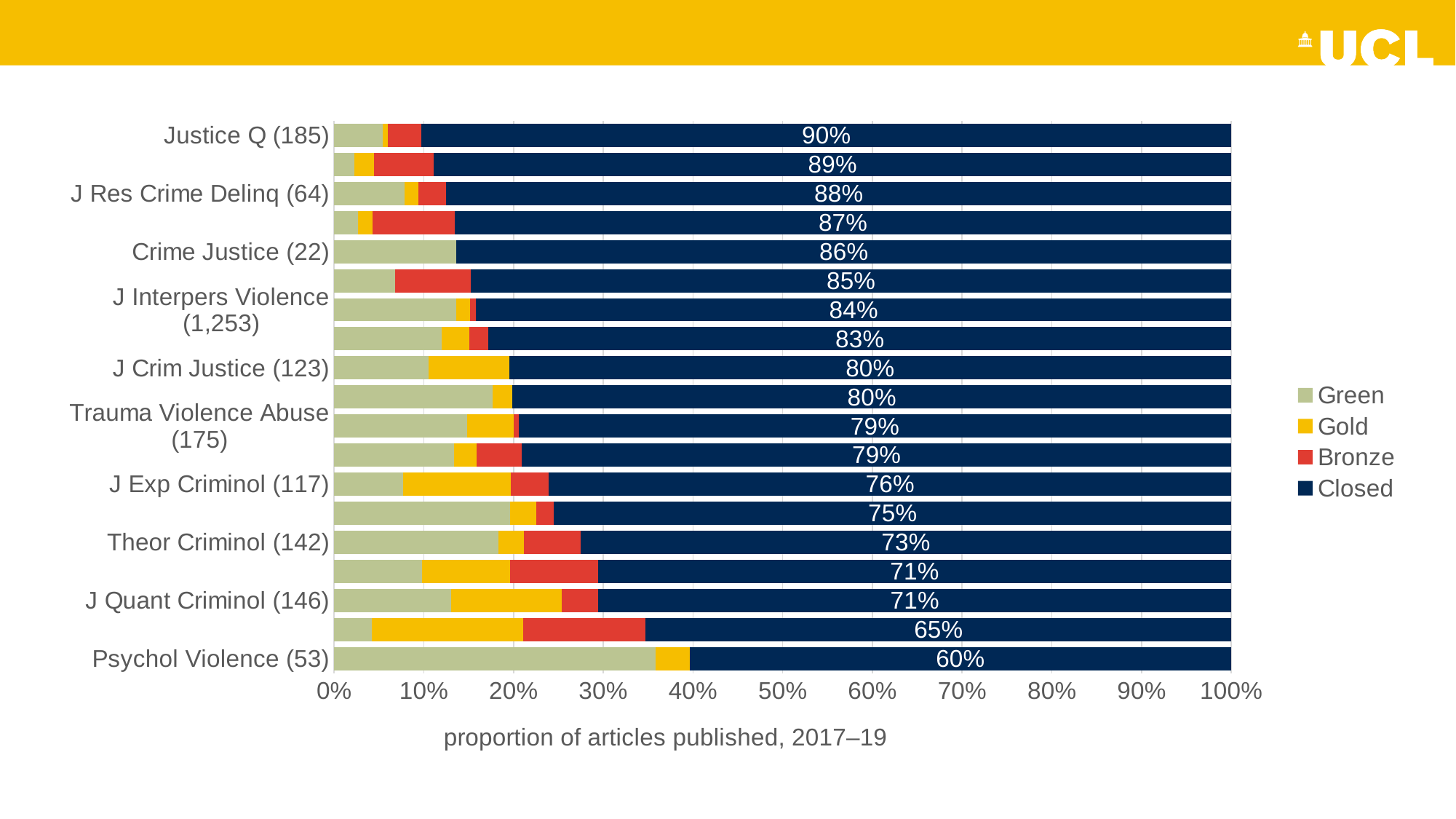
What is the Closed proportion for Theor Criminol (142)? 73% What is the Closed proportion for J Interpers Violence (1,253)? 84% What is the Closed proportion for Psychol Violence (53)? 60% What kind of chart is shown on the slide? Stacked bar chart How many series does the legend list? 4 Which journal has the highest Closed proportion? Justice Q (185) Which has a larger Closed proportion, J Exp Criminol (117) or J Quant Criminol (146)? J Exp Criminol (117) What is the difference in Closed proportion between Justice Q (185) and Psychol Violence (53)? 30 percentage points Is the Green proportion for Psychol Violence (53) greater or less than 30%? greater Which journal has the lowest Closed proportion? Psychol Violence (53) What is the title of the horizontal axis? proportion of articles published, 2017–19 What is the Closed proportion for Justice Q (185)? 90%